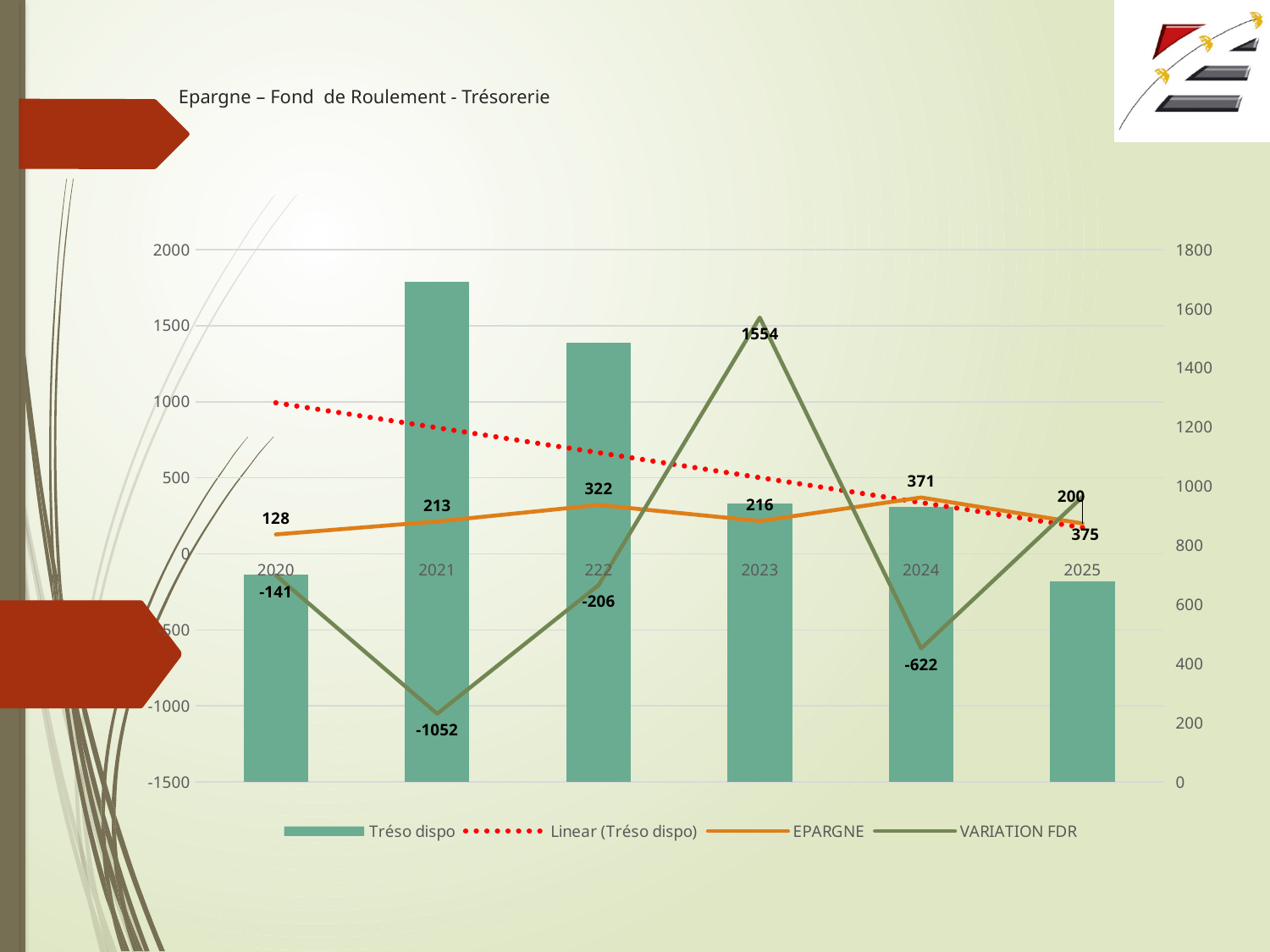
In which year is the EPARGNE value highest? 2024 What is the VARIATION FDR value for 2021? -1052 Does the dotted Linear (Tréso dispo) trendline rise or fall from 2020 to 2025? fall What is the VARIATION FDR value for 2023? 1554 In which year is the VARIATION FDR value lowest? 2021 What is the EPARGNE value for 2020? 128 What is the difference between the EPARGNE values for 2025 and 2020? 72 How many series does the legend list? 4 Which year has the tallest Tréso dispo bar? 2021 How many years are shown on the x axis? 6 What is the EPARGNE value for 2024? 371